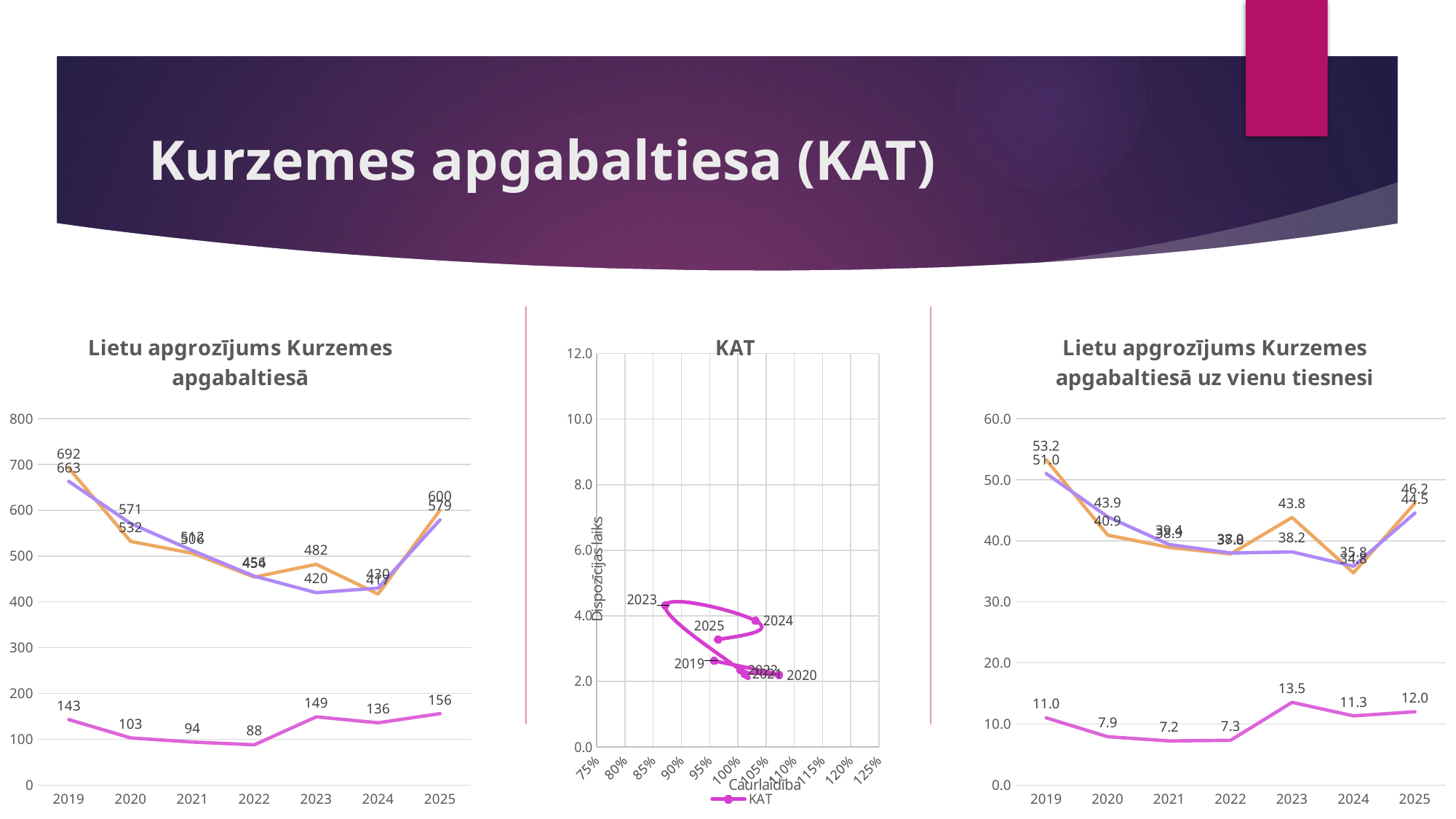
On the chart titled 'Lietu apgrozījums Kurzemes apgabaltiesā', in which year does the bottom (pink) line reach its highest value? 2025 On the chart titled 'Lietu apgrozījums Kurzemes apgabaltiesā', what is the highest value labeled on the chart? 692 On the chart titled 'Lietu apgrozījums Kurzemes apgabaltiesā', how many years are shown on the x axis? 7 On the chart titled 'Lietu apgrozījums Kurzemes apgabaltiesā', what is the difference between the bottom (pink) line's values in 2025 and 2019? 13 What kind of chart is the left chart titled 'Lietu apgrozījums Kurzemes apgabaltiesā'? line chart On the middle chart titled 'KAT', is the Dispozīcijas laiks value for 2025 greater or less than 4.0? less On the chart titled 'Lietu apgrozījums Kurzemes apgabaltiesā uz vienu tiesnesi', what is the difference between the bottom (pink) line's values in 2023 and 2022? 6.2 On the chart titled 'Lietu apgrozījums Kurzemes apgabaltiesā', in which year does the bottom (pink) line reach its lowest value? 2022 On the middle chart titled 'KAT', what is the label of the x axis? Caurlaidība On the chart titled 'Lietu apgrozījums Kurzemes apgabaltiesā', what is the value of the bottom (pink) line in 2022? 88 On the chart titled 'Lietu apgrozījums Kurzemes apgabaltiesā uz vienu tiesnesi', does the bottom (pink) line rise or fall from 2019 to 2022? fall On the chart titled 'Lietu apgrozījums Kurzemes apgabaltiesā uz vienu tiesnesi', what is the value of the bottom (pink) line in 2023? 13.5